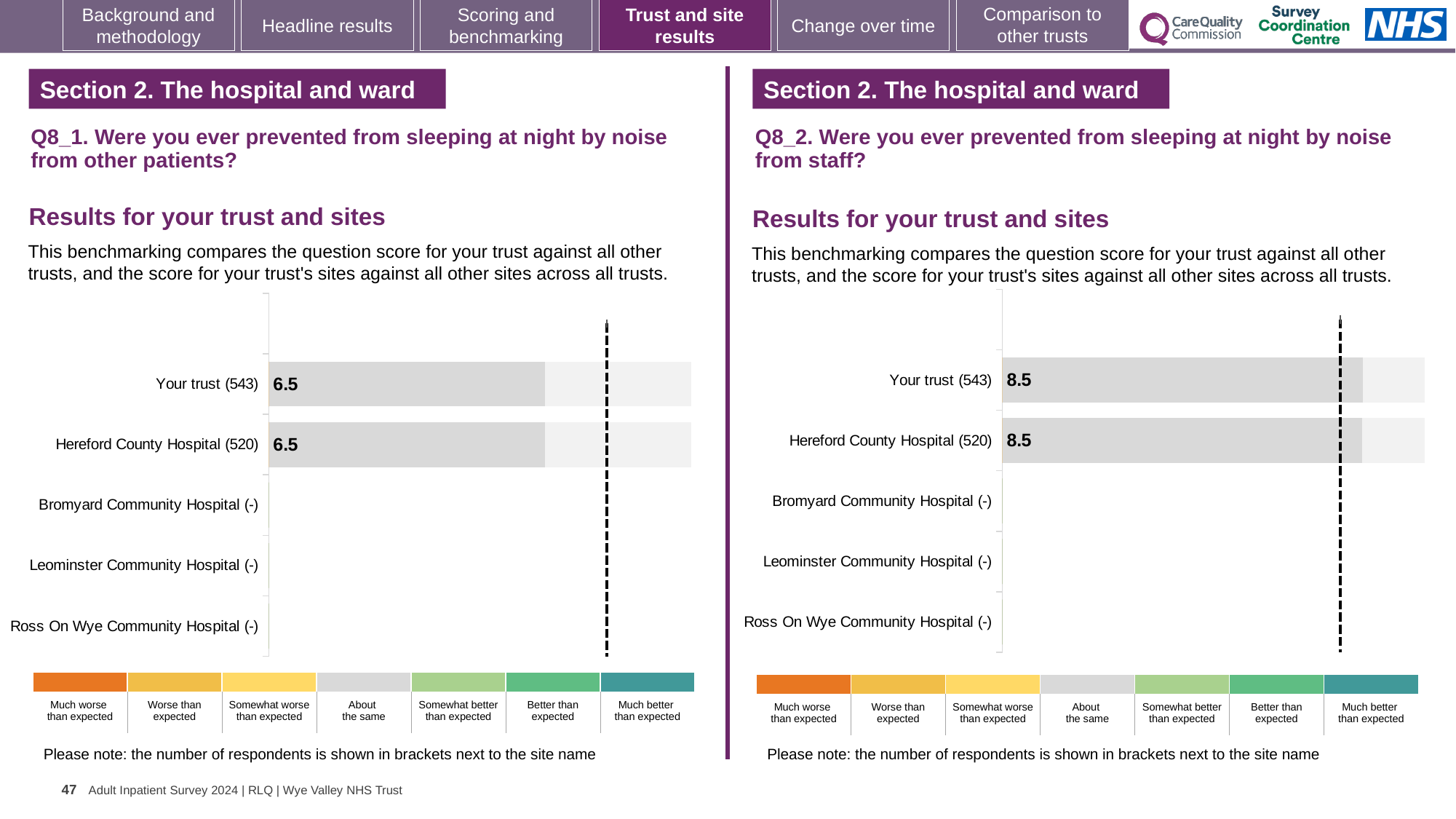
What is the difference between the Your trust score on the Q8_2 chart (right) and the Your trust score on the Q8_1 chart (left)? 2 On the Q8_2 chart (right), what is the score for Hereford County Hospital (520)? 8.5 What kind of chart is used on the Q8_1 chart (left)? Bar chart How many benchmark categories are shown in the colour legend below the Q8_1 chart (left)? 7 How many respondents are shown in brackets for Hereford County Hospital on the Q8_2 chart (right)? 520 How many sites (categories) are listed on the Q8_1 chart (left)? 5 On the Q8_1 chart (left), what is the score for Your trust (543)? 6.5 On the Q8_1 chart (left), what is the score for Hereford County Hospital (520)? 6.5 On the Q8_1 chart (left), what is the difference between the score for Your trust and the score for Hereford County Hospital? 0 On the Q8_2 chart (right), what is the score for Your trust (543)? 8.5 How many sites on the Q8_2 chart (right) have a plotted bar? 2 Is the Your trust score higher on the Q8_1 chart (left) or the Q8_2 chart (right)? Q8_2 chart (right)